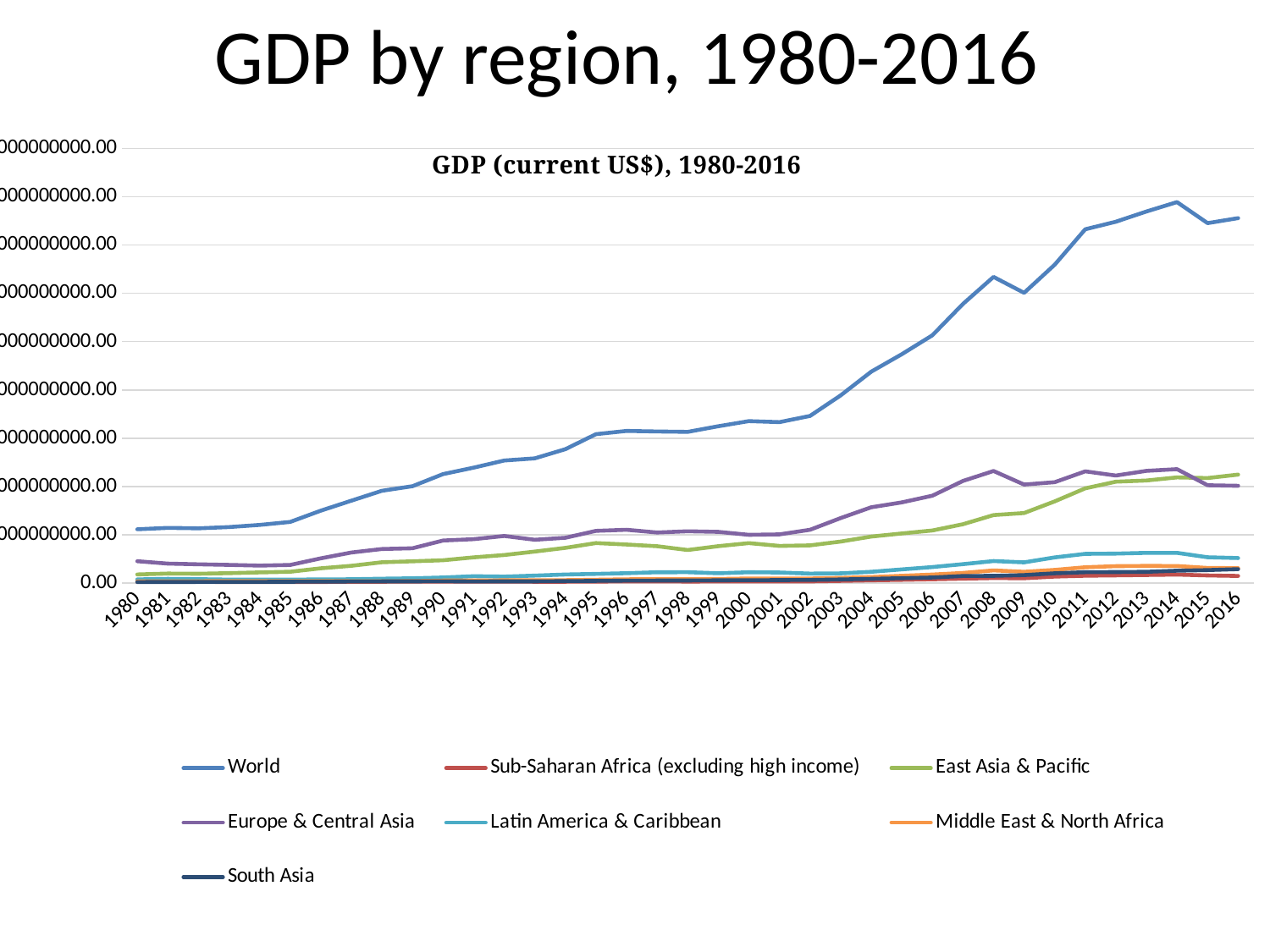
How many years are plotted along the x axis? 37 How many series does the legend list? 7 In which year does the World series reach its peak? 2014 Which series is higher in 2000, Europe & Central Asia or East Asia & Pacific? Europe & Central Asia Which series is higher in 2016, Latin America & Caribbean or Sub-Saharan Africa (excluding high income)? Latin America & Caribbean Does the East Asia & Pacific series rise or fall from 2000 to 2014? rise Which series has the highest values across the chart? World What is the last year shown on the x axis? 2016 What is the first year shown on the x axis? 1980 What kind of chart is shown on the slide? line chart Does the World series generally rise or fall from 1980 to 2016? rise Which series is higher in 2016, East Asia & Pacific or Europe & Central Asia? East Asia & Pacific